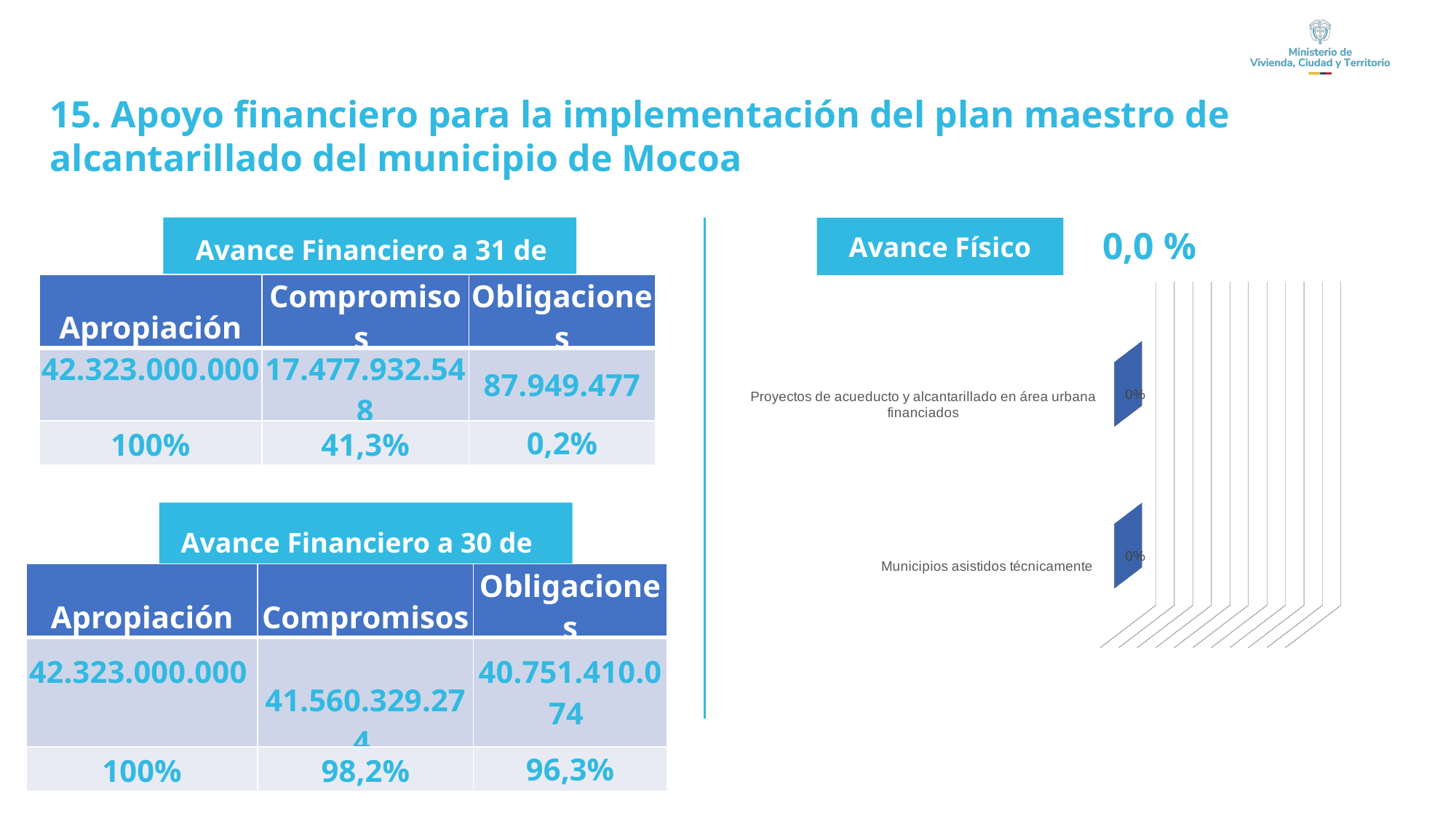
What kind of chart is shown under the heading "Avance Físico"? bar chart In the "Avance Físico" chart, what is the value labelled for "Proyectos de acueducto y alcantarillado en área urbana financiados"? 0% In the "Avance Físico" chart, what is the value labelled for "Municipios asistidos técnicamente"? 0% How many categories are plotted in the "Avance Físico" chart? 2 Which category label appears at the top of the "Avance Físico" bar chart? Proyectos de acueducto y alcantarillado en área urbana financiados What overall percentage is printed next to the "Avance Físico" heading above the chart? 0,0 %